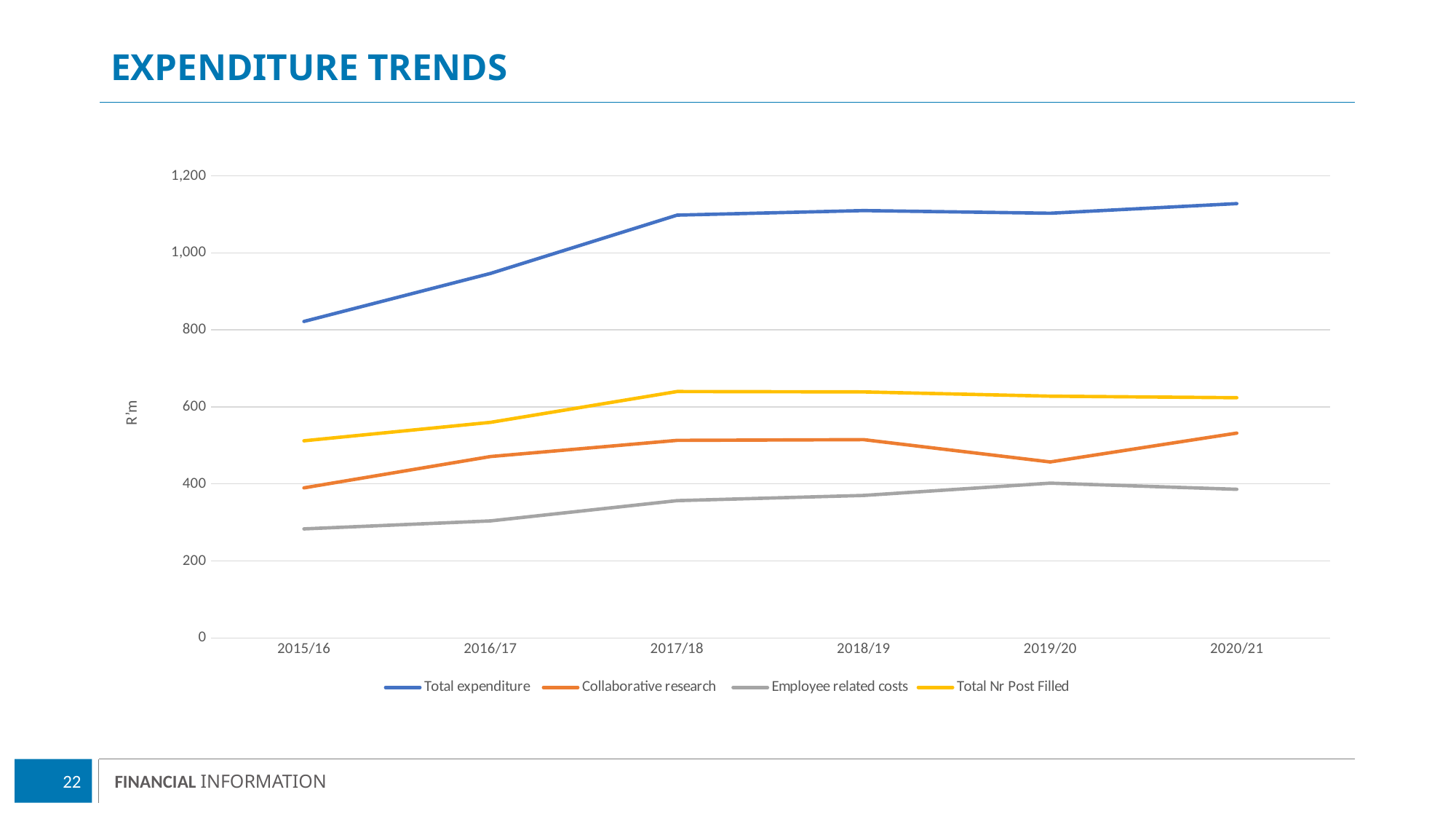
Is the value for Total expenditure in 2017/18 greater or less than 1,000? greater In which year is Collaborative research at its lowest? 2015/16 Does Total expenditure rise or fall from 2015/16 to 2017/18? rise What kind of chart is shown on the slide? Line chart Is the value for Employee related costs in 2015/16 greater or less than 400? less Is the value for Total Nr Post Filled in 2017/18 greater or less than 600? greater What is the label on the vertical axis? R'm Which series has the highest values across all years? Total expenditure In which year is Employee related costs at its highest? 2019/20 How many financial years are plotted along the x axis? 6 How many series does the legend list? 4